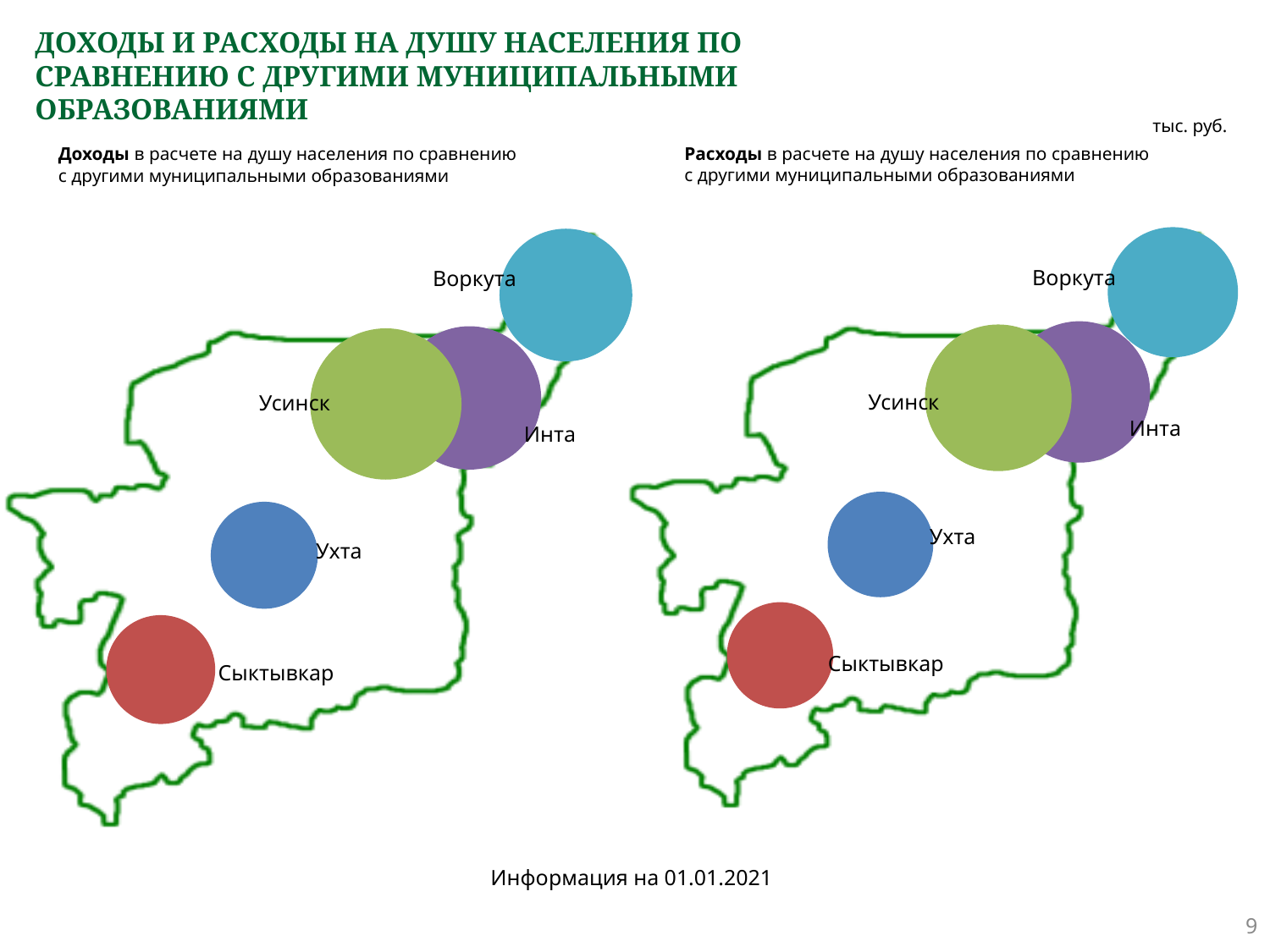
On the right (Расходы) chart, which bubble is larger: Воркута or Ухта? Воркута What unit of measurement is stated for the charts on the slide? тыс. руб. On the right (Расходы) chart, which bubble is larger: Усинск or Сыктывкар? Усинск Which municipality is represented by the blue bubble on the left (Доходы) chart? Ухта On the left (Доходы) chart, which bubble is larger: Усинск or Ухта? Усинск How many municipalities are shown as bubbles on the right (Расходы) chart? 5 What colour is the bubble for Сыктывкар on the left (Доходы) chart? red What kind of chart is used on the left (Доходы) side of the slide? bubble chart How many municipalities are shown as bubbles on the left (Доходы) chart? 5 Which municipality is represented by the purple bubble on the right (Расходы) chart? Инта